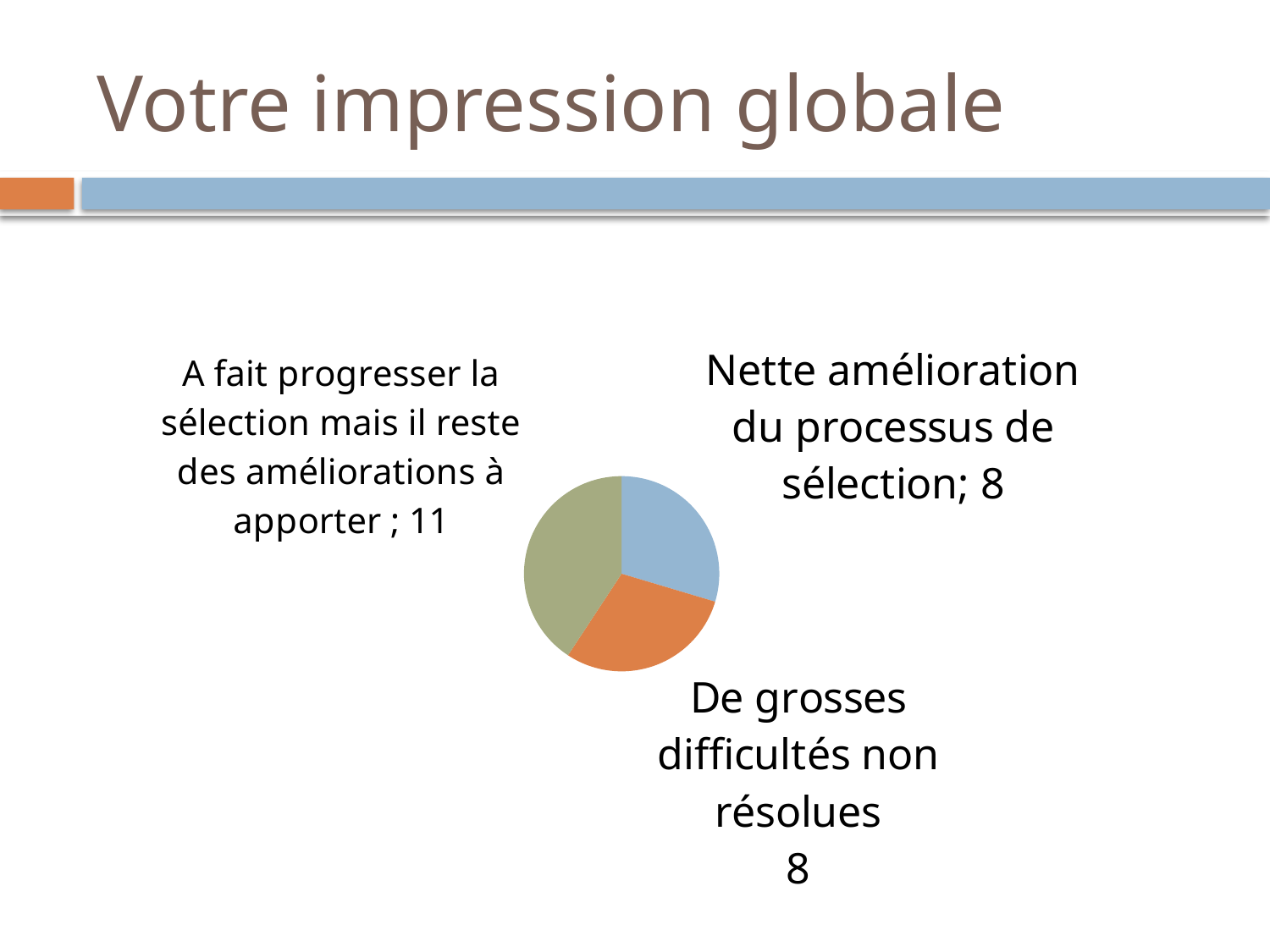
What is the title of the slide containing the pie chart? Votre impression globale Which is larger: the value for "A fait progresser la sélection mais il reste des améliorations à apporter" or the value for "De grosses difficultés non résolues"? A fait progresser la sélection mais il reste des améliorations à apporter What is the difference between the value for "A fait progresser la sélection mais il reste des améliorations à apporter" and the value for "Nette amélioration du processus de sélection"? 3 What share of the total does "A fait progresser la sélection mais il reste des améliorations à apporter" represent? 11 out of 27 Which category has the largest slice of the pie? A fait progresser la sélection mais il reste des améliorations à apporter What type of chart is shown on the slide? Pie chart What is the total of all the values in the pie chart? 27 What is the value for "A fait progresser la sélection mais il reste des améliorations à apporter"? 11 What is the value for "Nette amélioration du processus de sélection"? 8 What is the value for "De grosses difficultés non résolues"? 8 Which category is shown in orange in the pie chart? De grosses difficultés non résolues How many slices does the pie chart have? 3